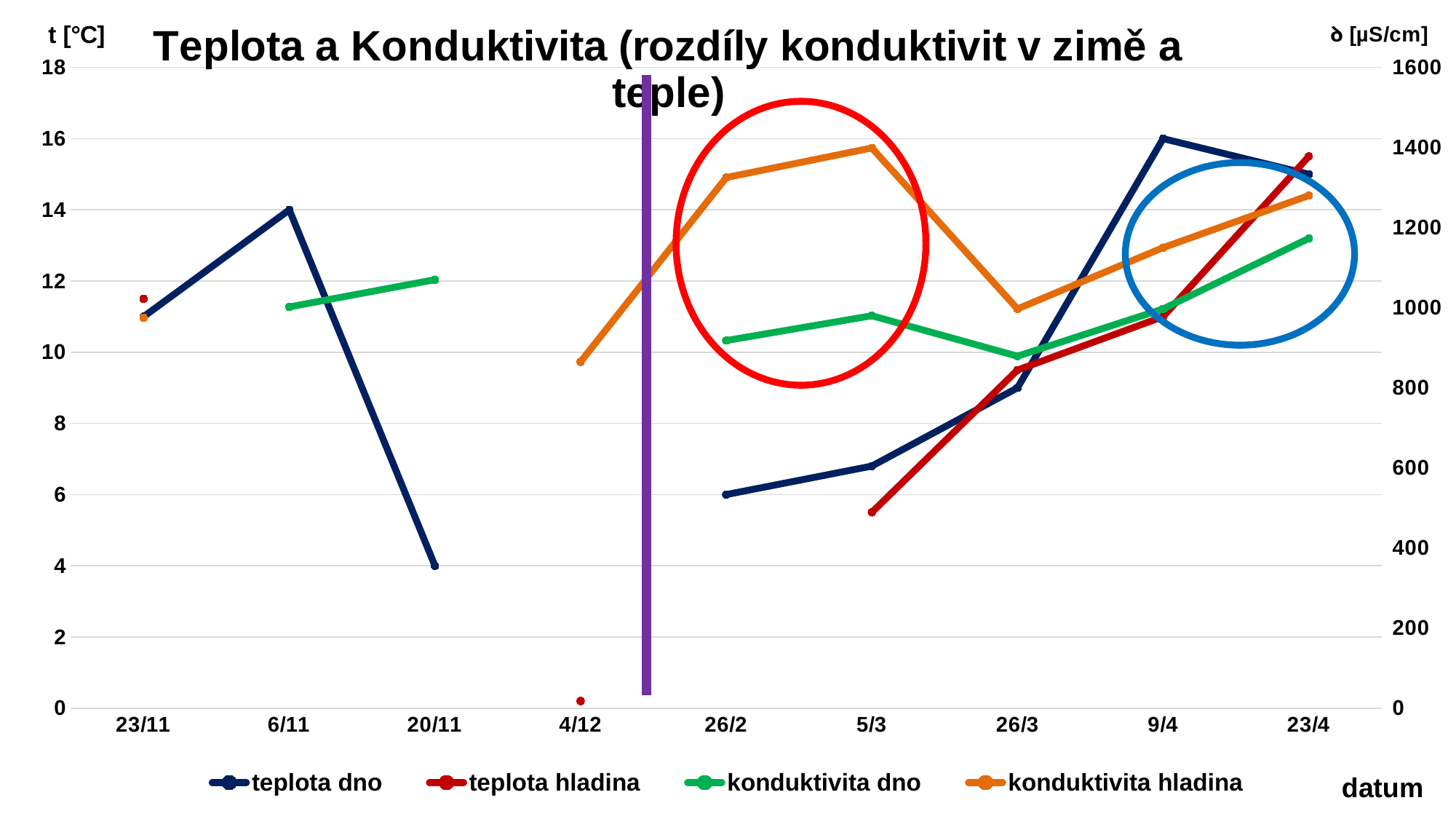
How many dates are shown on the x axis? 9 On which date does teplota dno reach its lowest value? 20/11 What is the value of teplota dno on 9/4? 16 Which is larger: teplota dno on 6/11 or on 26/2? 6/11 On which date does teplota dno reach its highest value? 9/4 Is the value for konduktivita hladina on 5/3 greater or less than 1200? greater How many series does the legend list? 4 What is the value of teplota dno on 20/11? 4 What kind of chart is shown on the slide? line chart What is the value of teplota dno on 6/11? 14 Does teplota hladina rise or fall from 5/3 to 23/4? rise What is the difference between teplota dno on 9/4 and on 20/11? 12